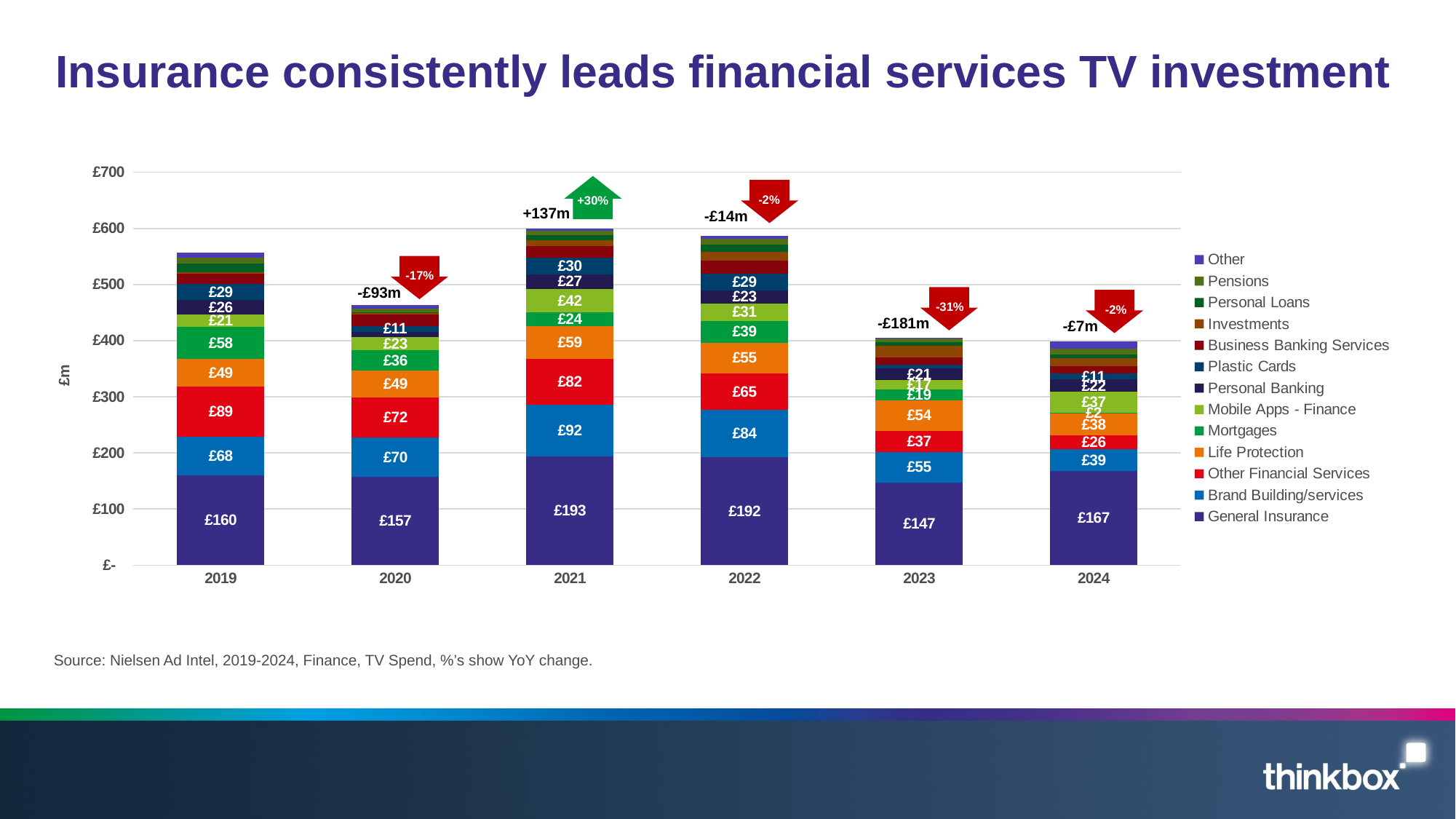
What kind of chart is shown on the slide? Stacked bar chart Is the total height of the 2023 bar greater or less than £500? less What is the difference between the Other Financial Services values in 2019 and 2024? £63 What was the Mortgages value in 2024? £2 How many series does the legend list? 13 In which year was the General Insurance segment lowest? 2023 What was the General Insurance TV spend in 2021? £193 How many years are shown on the x axis? 6 What was the Brand Building/services value in 2022? £84 Which year had the larger Life Protection value, 2021 or 2022? 2021 Does the Other Financial Services value rise or fall from 2021 to 2024? Fall What year-on-year percentage change is shown above the 2023 bar? -31%